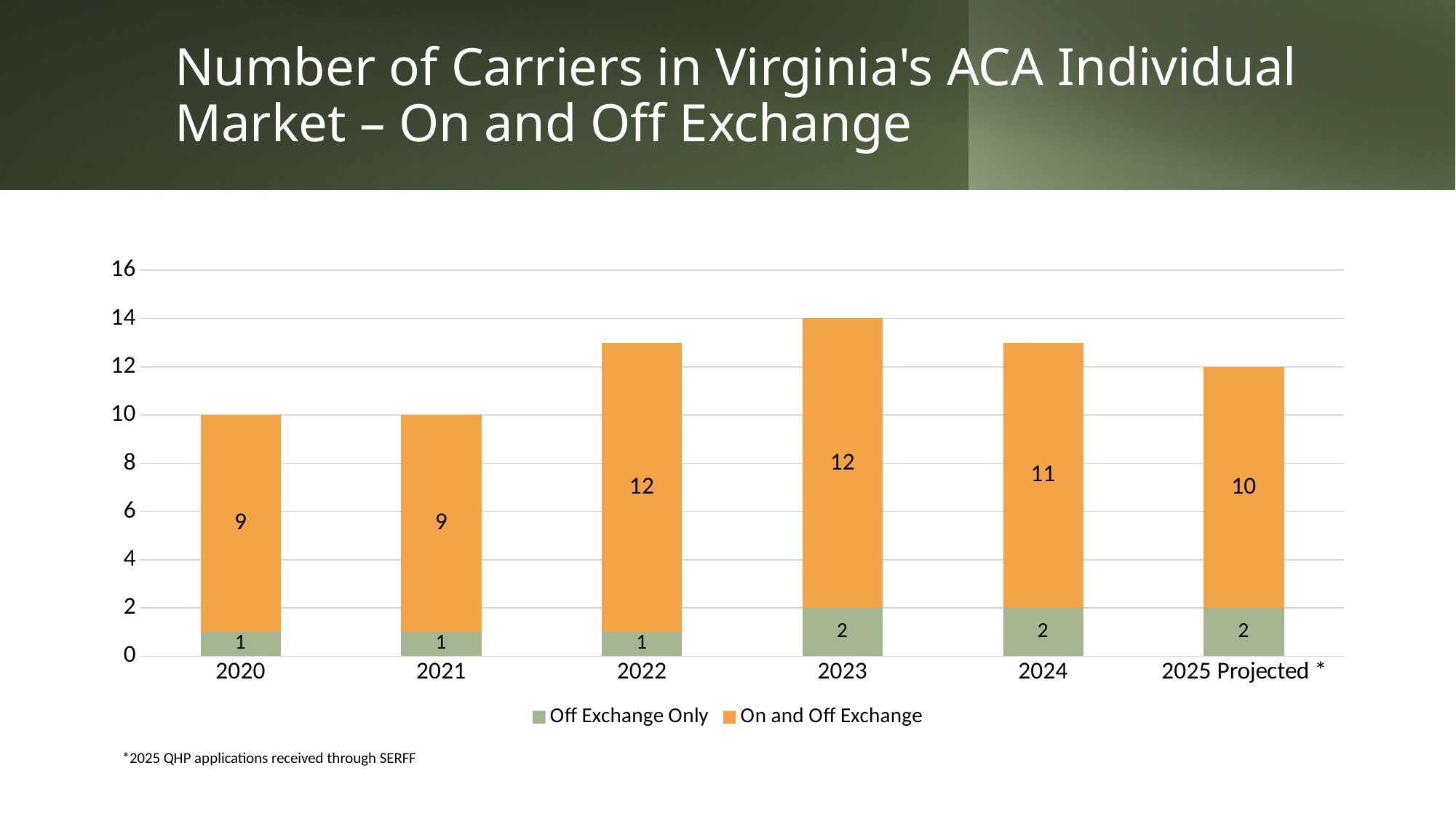
What is the value for On and Off Exchange in 2025 Projected? 10 Which year has the highest On and Off Exchange value? 2022 and 2023 (tied at 12) How many years (categories) are shown on the x axis? 6 What is the difference between the On and Off Exchange values for 2022 and 2025 Projected? 2 What is the total of the stacked bar for 2020? 10 How many series does the legend list? 2 What is the value for Off Exchange Only in 2021? 1 What is the value for On and Off Exchange in 2023? 12 Which colour represents the Off Exchange Only series? Green What kind of chart is shown on the slide? Stacked bar chart Which is larger, the On and Off Exchange value for 2024 or for 2021? 2024 What is the total of the stacked bar for 2024? 13